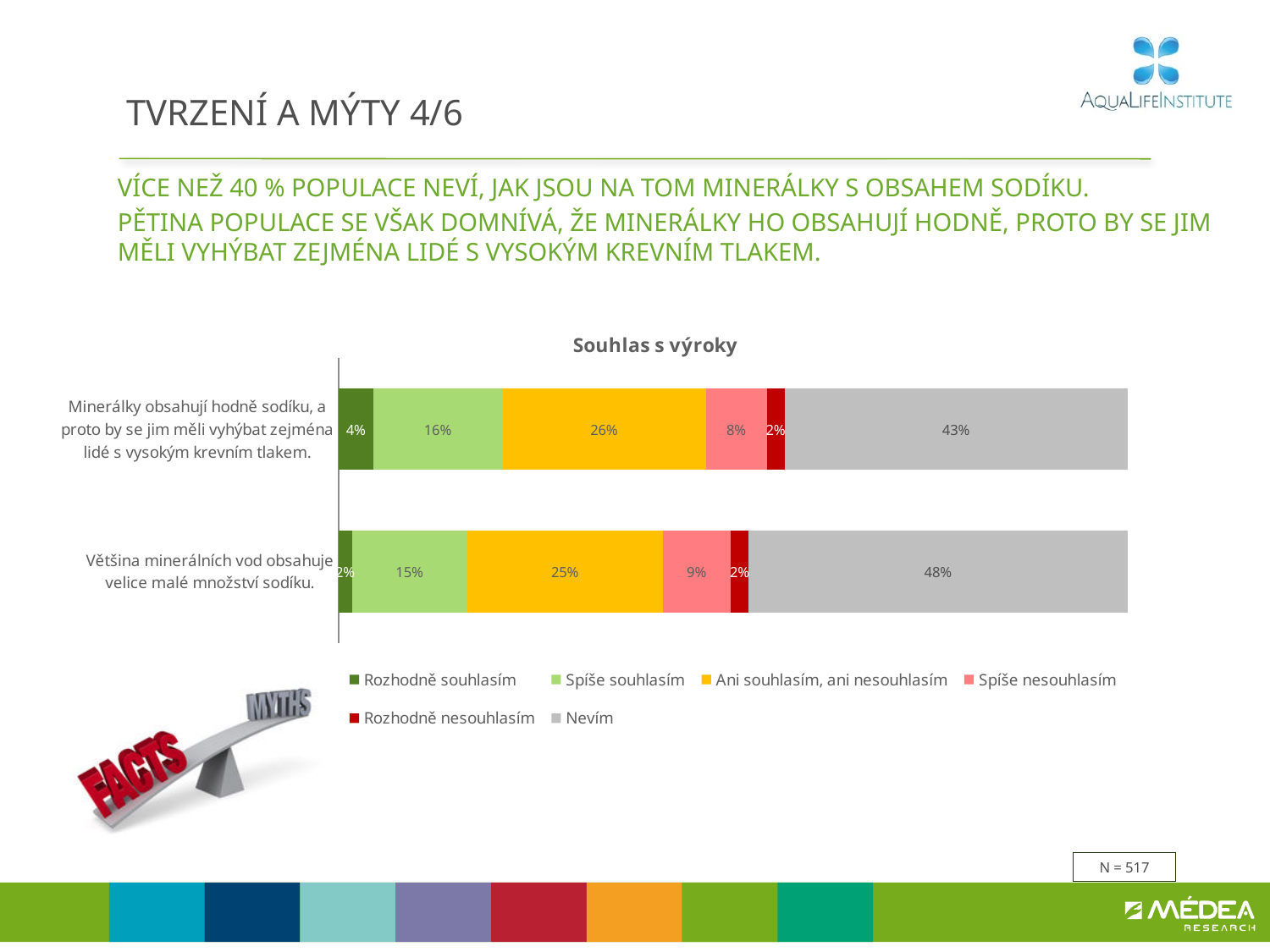
What is the 'Ani souhlasím, ani nesouhlasím' value for the statement 'Minerálky obsahují hodně sodíku, a proto by se jim měli vyhýbat zejména lidé s vysokým krevním tlakem.'? 26% How many statements (categories) are plotted in the chart? 2 What is the 'Nevím' value for the statement 'Většina minerálních vod obsahuje velice malé množství sodíku.'? 48% What is the 'Nevím' value for the statement 'Minerálky obsahují hodně sodíku, a proto by se jim měli vyhýbat zejména lidé s vysokým krevním tlakem.'? 43% What is the title of the chart? Souhlas s výroky What is the difference between the 'Nevím' values of the two statements? 5% Which segment is the largest in the bar for 'Minerálky obsahují hodně sodíku, a proto by se jim měli vyhýbat zejména lidé s vysokým krevním tlakem.'? Nevím What is the 'Rozhodně souhlasím' value for the statement 'Minerálky obsahují hodně sodíku, a proto by se jim měli vyhýbat zejména lidé s vysokým krevním tlakem.'? 4% What is the 'Spíše souhlasím' value for the statement 'Většina minerálních vod obsahuje velice malé množství sodíku.'? 15% How many series does the chart legend list? 6 Which statement has the higher 'Nevím' value? Většina minerálních vod obsahuje velice malé množství sodíku. What type of chart is shown on the slide? Stacked bar chart